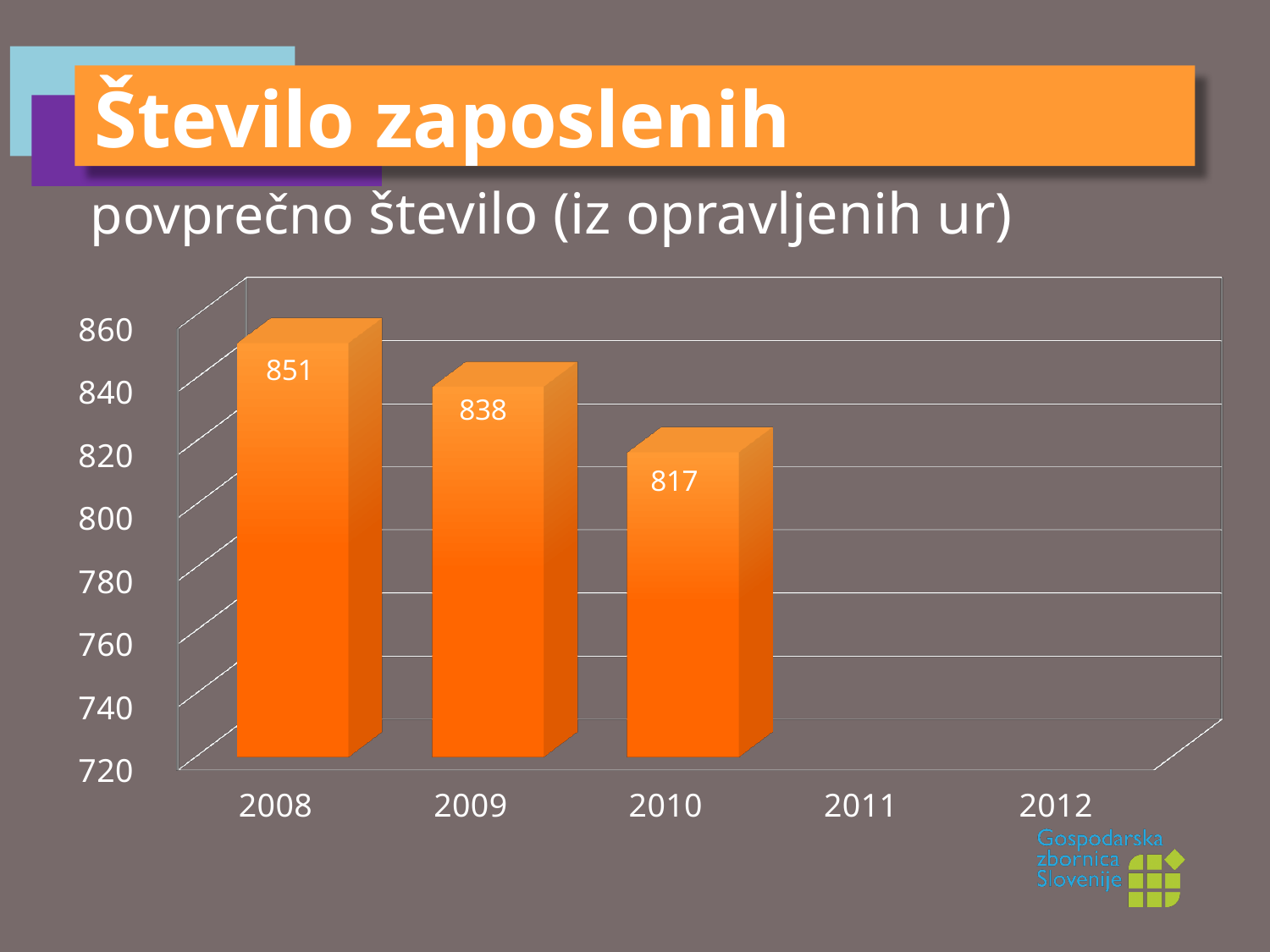
Is the value for 2010 greater or less than 820? less What is the difference between the values for 2008 and 2009? 13 How many bars are plotted on the chart? 3 What is the value for 2008? 851 What is the difference between the values for 2008 and 2010? 34 Which is larger, the value for 2009 or the value for 2010? 2009 Which year has the lowest value among the plotted bars? 2010 What is the value for 2009? 838 Which year has the highest value? 2008 What kind of chart is shown on the slide? bar chart What is the value for 2010? 817 Do the values rise or fall from 2008 to 2010? fall